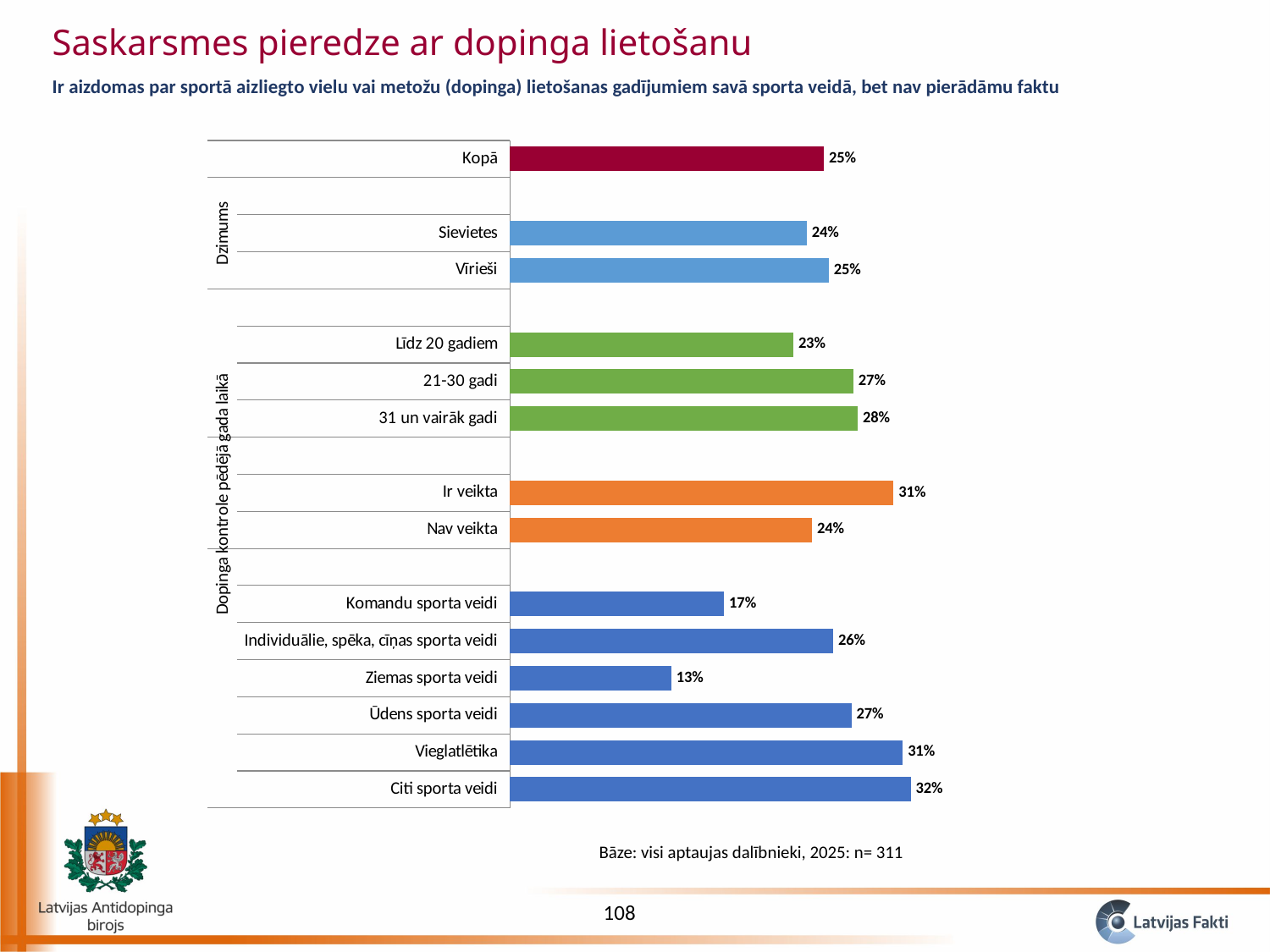
What is the value for Ziemas sporta veidi? 13% What is the value for 31 un vairāk gadi? 28% Which category has the lowest value? Ziemas sporta veidi What is the value for Kopā? 25% What is the difference between the values for Citi sporta veidi and Komandu sporta veidi? 15% What kind of chart is shown on the slide? Bar chart Which is larger, the value for 21-30 gadi or the value for Līdz 20 gadiem? 21-30 gadi What is the difference between the values for Ir veikta and Nav veikta? 7% What is the value for Ir veikta? 31% Which category has the highest value? Citi sporta veidi What colour is the bar for Kopā? Dark red How many bars are plotted in the chart? 14